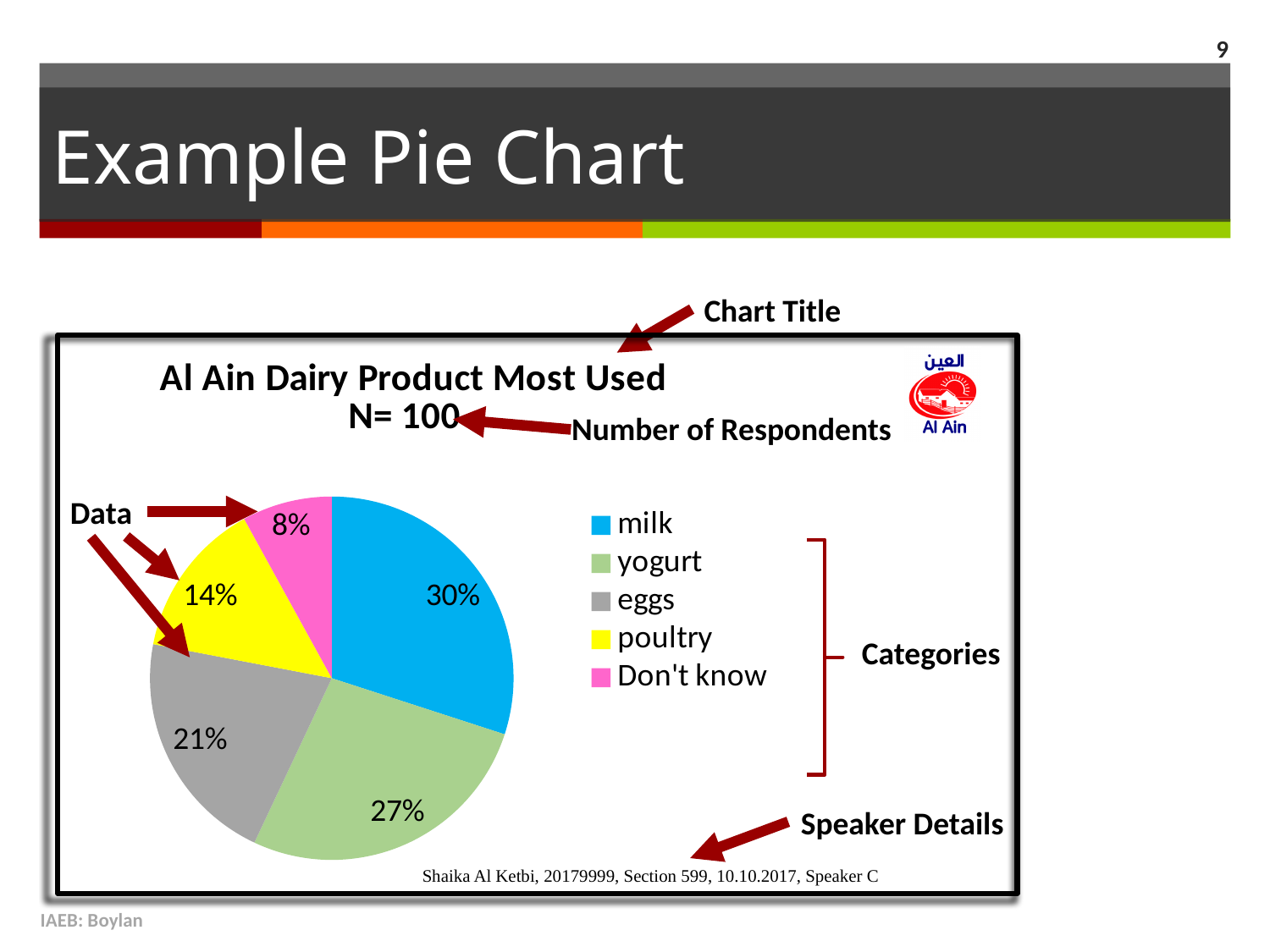
What percentage of respondents answered Don't know? 8% What type of chart is shown on the slide? pie chart How many categories does the legend list? 5 What percentage of respondents chose milk? 30% What percentage of respondents chose poultry? 14% What percentage of respondents chose yogurt? 27% Which category has the largest share of the pie? milk What percentage of respondents chose eggs? 21% Which is larger, the share for yogurt or the share for poultry? yogurt Which category has the smallest share of the pie? Don't know What is the difference in percentage points between milk and eggs? 9 What is the title of the chart? Al Ain Dairy Product Most Used